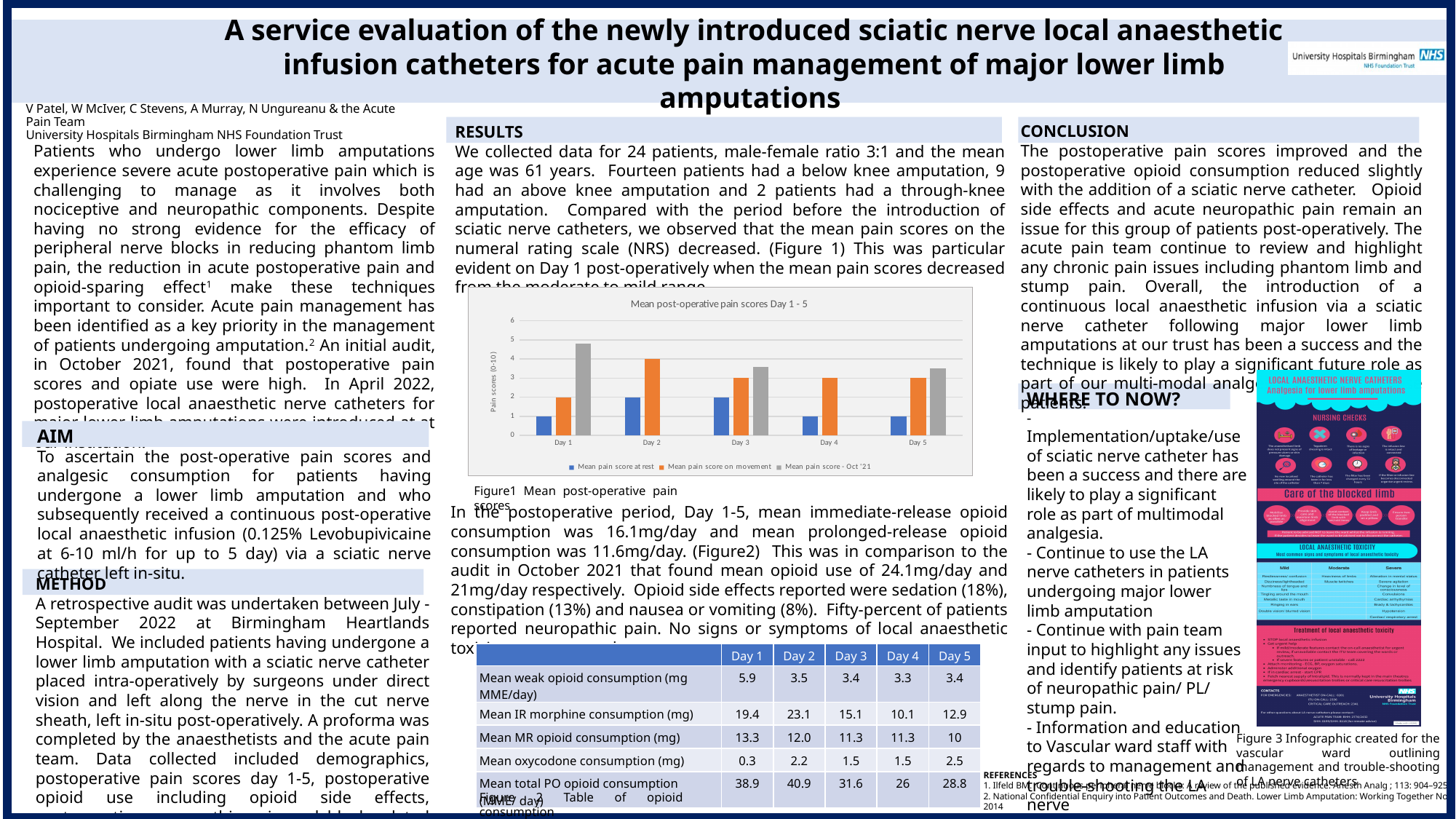
In the pain scores chart, on Day 1, which is larger: the mean pain score at rest or the mean pain score on movement? Mean pain score on movement What kind of chart is shown in Figure 1 (Mean post-operative pain scores Day 1 - 5)? bar chart How many series does the legend of the pain scores chart list? 3 In the pain scores chart, on which day is the mean pain score on movement highest? Day 2 In the pain scores chart, what is the mean pain score at rest on Day 1? 1 In the pain scores chart, is the mean pain score - Oct '21 value for Day 1 greater or less than 4? greater What is the title of the chart in Figure 1? Mean post-operative pain scores Day 1 - 5 In the pain scores chart, what is the difference between the mean pain score on movement and the mean pain score at rest on Day 2? 2 How many days (categories) are shown on the x axis of the pain scores chart? 5 In the pain scores chart, what is the mean pain score on movement on Day 2? 4 In the pain scores chart, is the mean pain score - Oct '21 value for Day 3 greater or less than 3? greater In the pain scores chart, what colour represents the Mean pain score - Oct '21 series? grey